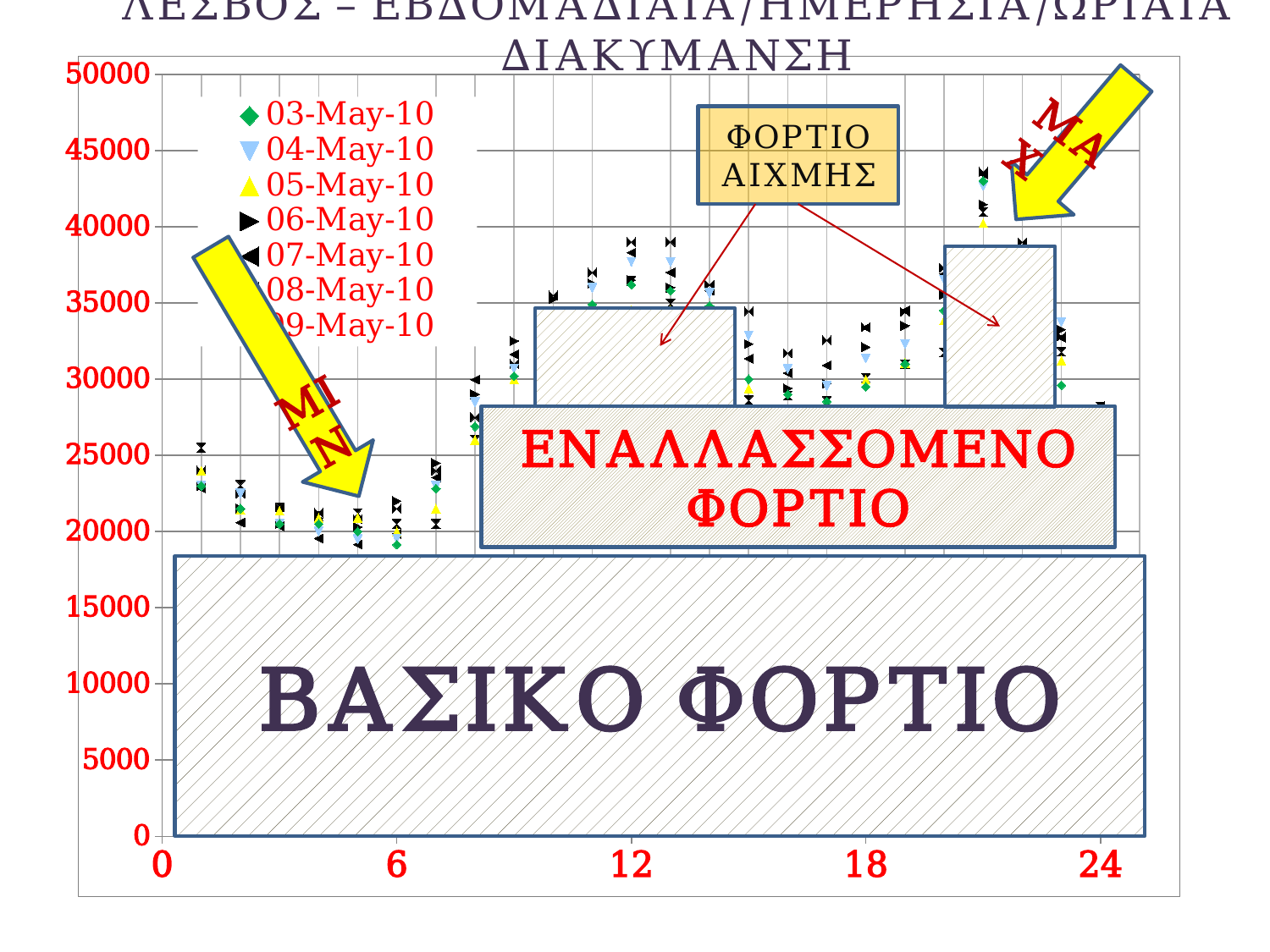
Do the plotted values rise or fall between hour 1 and hour 5? fall Are the plotted values at hour 5 greater or less than 25000? less What kind of chart is shown on the slide? scatter chart What is the highest value labelled on the vertical axis? 50000 Do the plotted values rise or fall between hour 8 and hour 13? rise Are the highest plotted values at hour 21 greater or less than 40000? greater Which hour has higher plotted values, hour 21 or hour 13? hour 21 Are the plotted values at hour 13 greater or less than 30000? greater Around which hour on the x axis do the plotted values reach their highest level? 21 How many series does the legend list? 7 Which hour has higher plotted values, hour 13 or hour 17? hour 13 What is the first series listed in the legend? 03-May-10